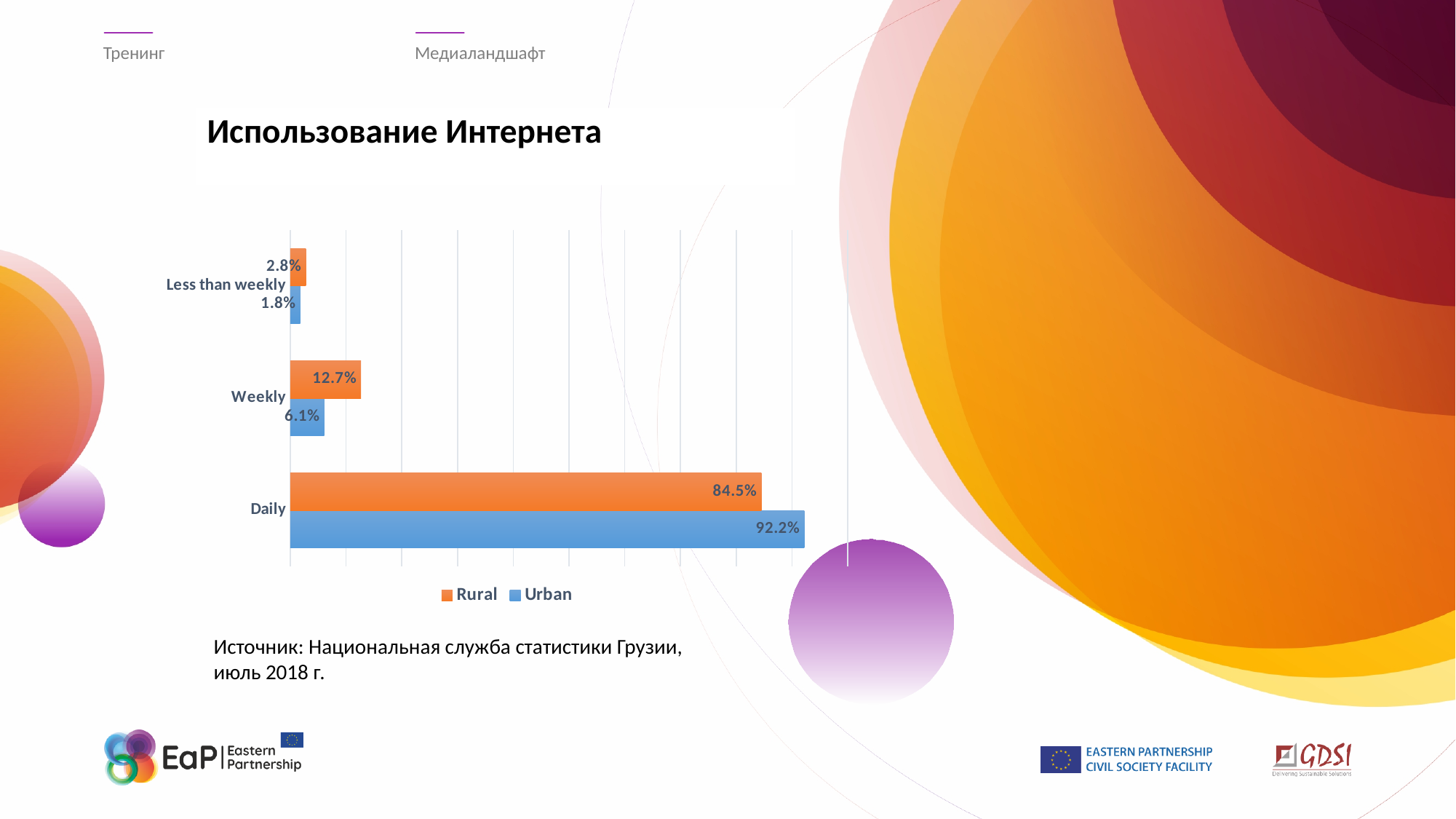
What is the Urban value for Less than weekly internet use? 1.8% What is the Urban value for Daily internet use? 92.2% Which category has the lowest Rural value? Less than weekly What is the Rural value for Weekly internet use? 12.7% How many categories are shown on the chart? 3 For Weekly, which is larger: the Rural value or the Urban value? Rural What is the difference between the Urban and Rural values for Daily? 7.7% What type of chart is shown on the slide? Bar chart What is the difference between the Rural and Urban values for Weekly? 6.6% Which category has the highest Urban value? Daily What is the Rural value for Daily internet use? 84.5% How many series does the legend list? 2